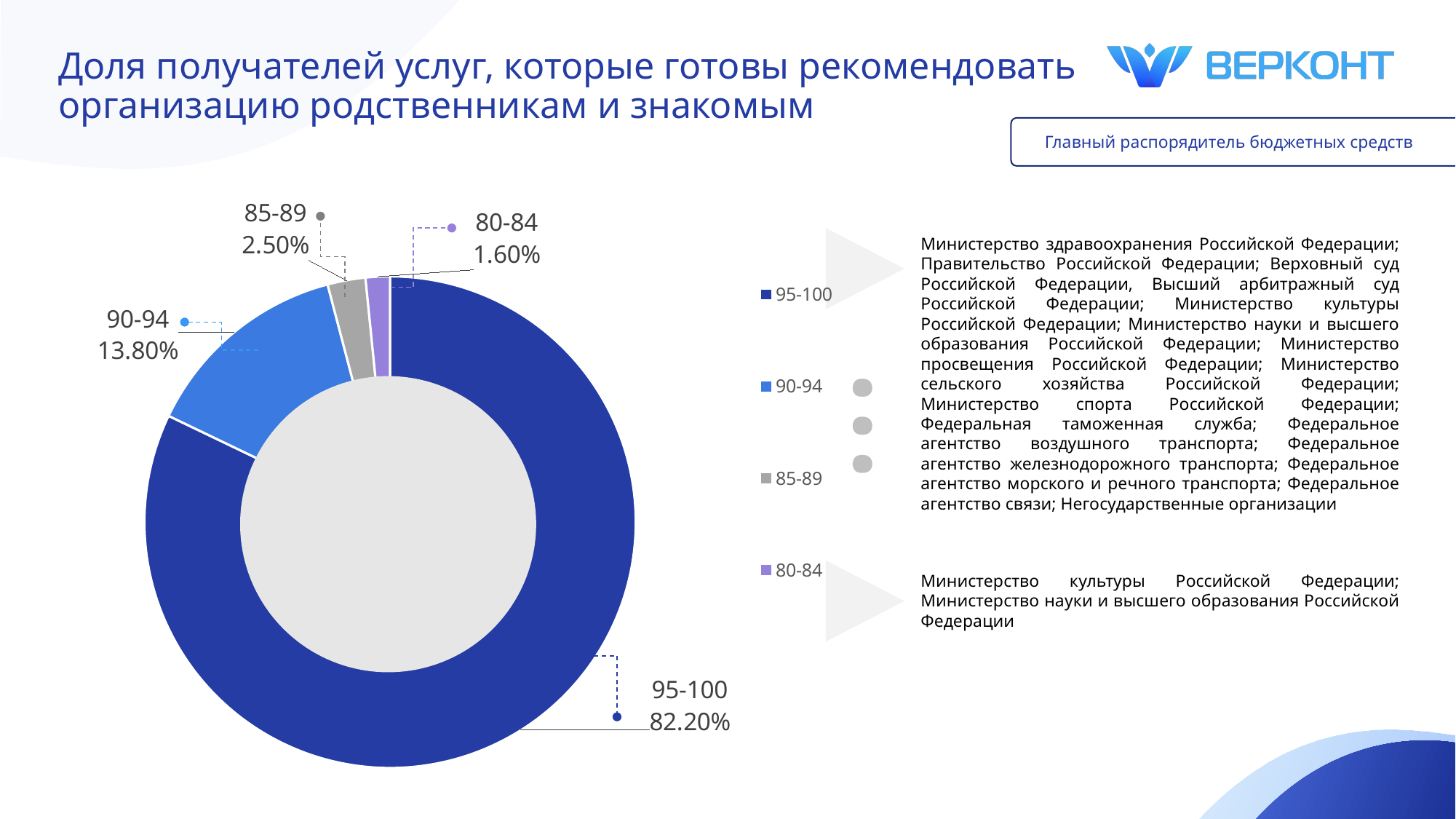
Which category has the smallest share of the chart? 80-84 What is the difference in percentage points between the 95-100 and 90-94 categories? 68.40 Which category has the largest share of the chart? 95-100 Which category has a larger share: 90-94 or 85-89? 90-94 How many categories are shown in the chart? 4 What is the value shown for the 85-89 category? 2.50% What is the value shown for the 80-84 category? 1.60% What share of the chart does the 95-100 category account for? 82.20% What is the value shown for the 90-94 category? 13.80% How many entries does the chart legend list? 4 What is the difference in percentage points between the 85-89 and 80-84 categories? 0.90 What type of chart is shown on the slide? Doughnut (pie) chart